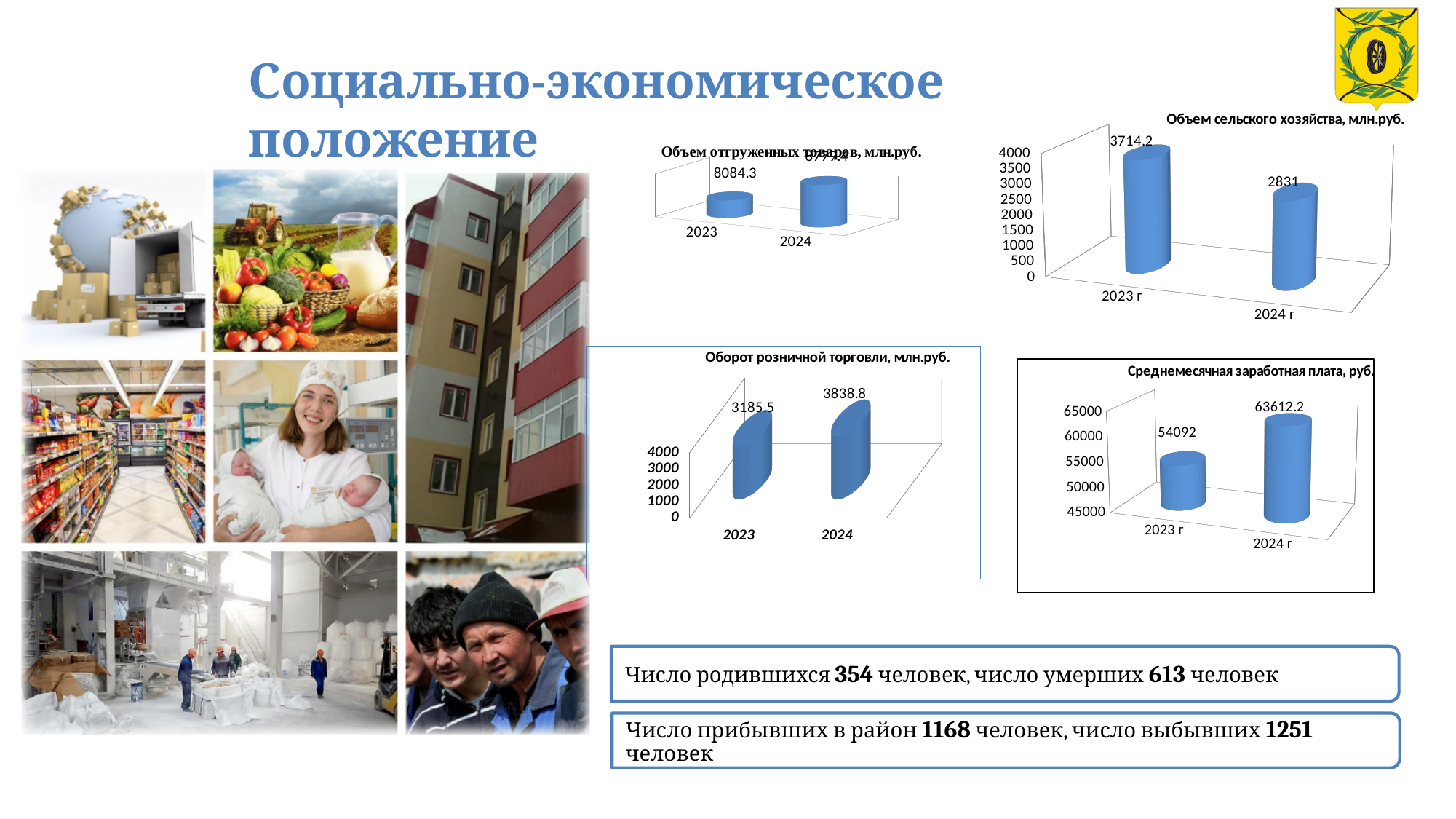
In the chart titled "Объем отгруженных товаров, млн.руб.", what is the value for 2023? 8084.3 In the chart titled "Оборот розничной торговли, млн.руб.", what is the value for 2024? 3838.8 In the chart titled "Оборот розничной торговли, млн.руб.", by how much did the value increase from 2023 to 2024? 653.3 In the chart titled "Среднемесячная заработная плата, руб.", what is the value for 2023 г? 54092 In the chart titled "Объем сельского хозяйства, млн.руб.", what is the value for 2023 г? 3714.2 In the chart titled "Объем сельского хозяйства, млн.руб.", what is the value for 2024 г? 2831 In the chart titled "Оборот розничной торговли, млн.руб.", which year has the lower value? 2023 In the chart titled "Среднемесячная заработная плата, руб.", what is the difference between the 2024 г and 2023 г values? 9520.2 In the chart titled "Среднемесячная заработная плата, руб.", what is the value for 2024 г? 63612.2 In the chart titled "Объем сельского хозяйства, млн.руб.", what is the difference between the 2023 г and 2024 г values? 883.2 In the chart titled "Объем отгруженных товаров, млн.руб.", which year has the larger value, 2023 or 2024? 2024 How many charts are shown on the slide? 4